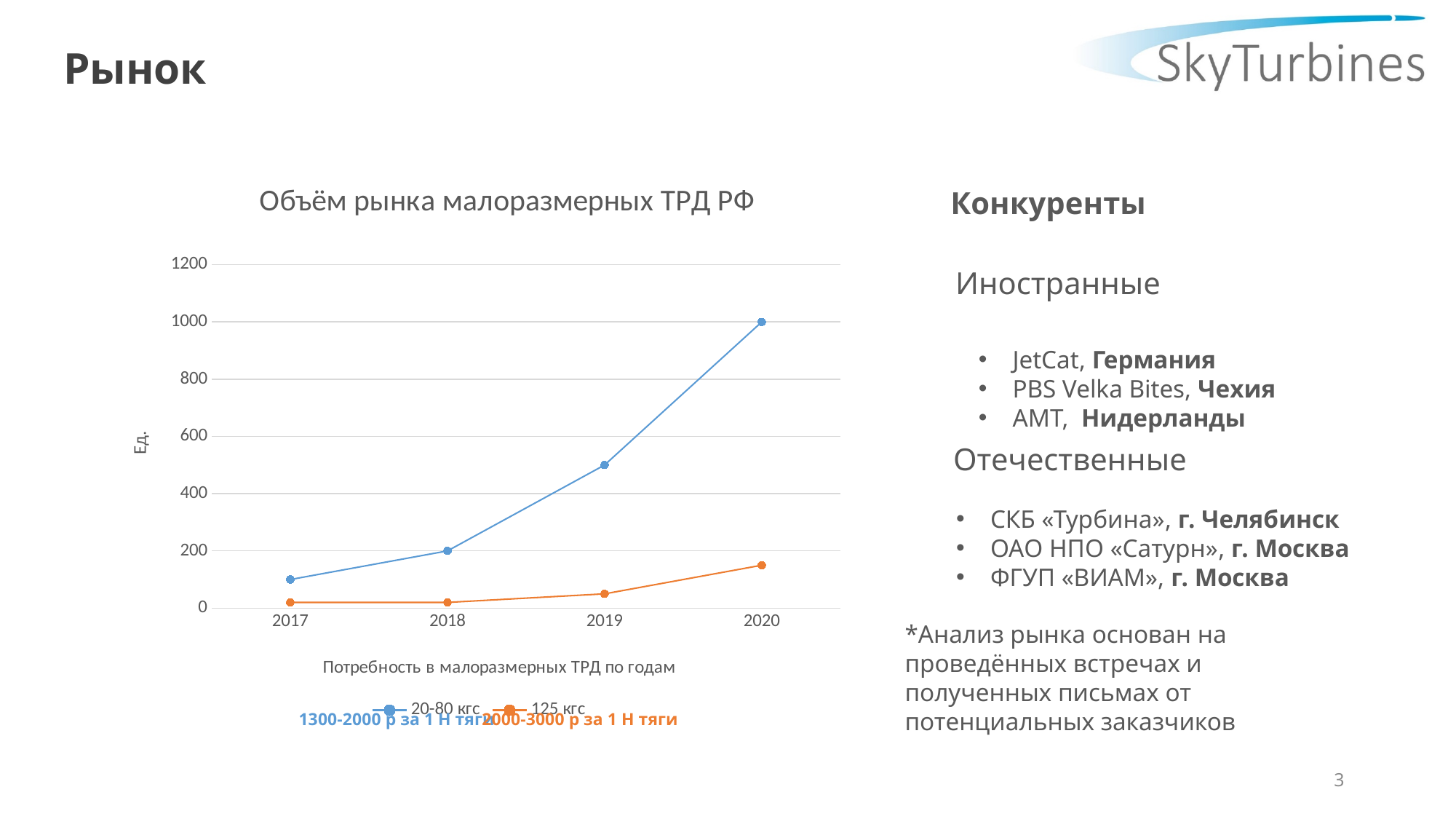
Is the value for the 20-80 кгс series in 2019 greater or less than 400? greater Is the value for the 125 кгс series in 2020 greater or less than 200? less Which series has the larger value in 2020, 20-80 кгс or 125 кгс? 20-80 кгс What is the value for the 20-80 кгс series in 2018? 200 How many years are plotted along the x axis? 4 Does the 20-80 кгс series rise or fall from 2017 to 2020? rise What kind of chart is shown on the slide? line chart What is the title of the chart? Объём рынка малоразмерных ТРД РФ How many series does the chart legend list? 2 In which year is the 20-80 кгс series lowest? 2017 In which year is the 20-80 кгс series highest? 2020 What is the value for the 20-80 кгс series in 2020? 1000